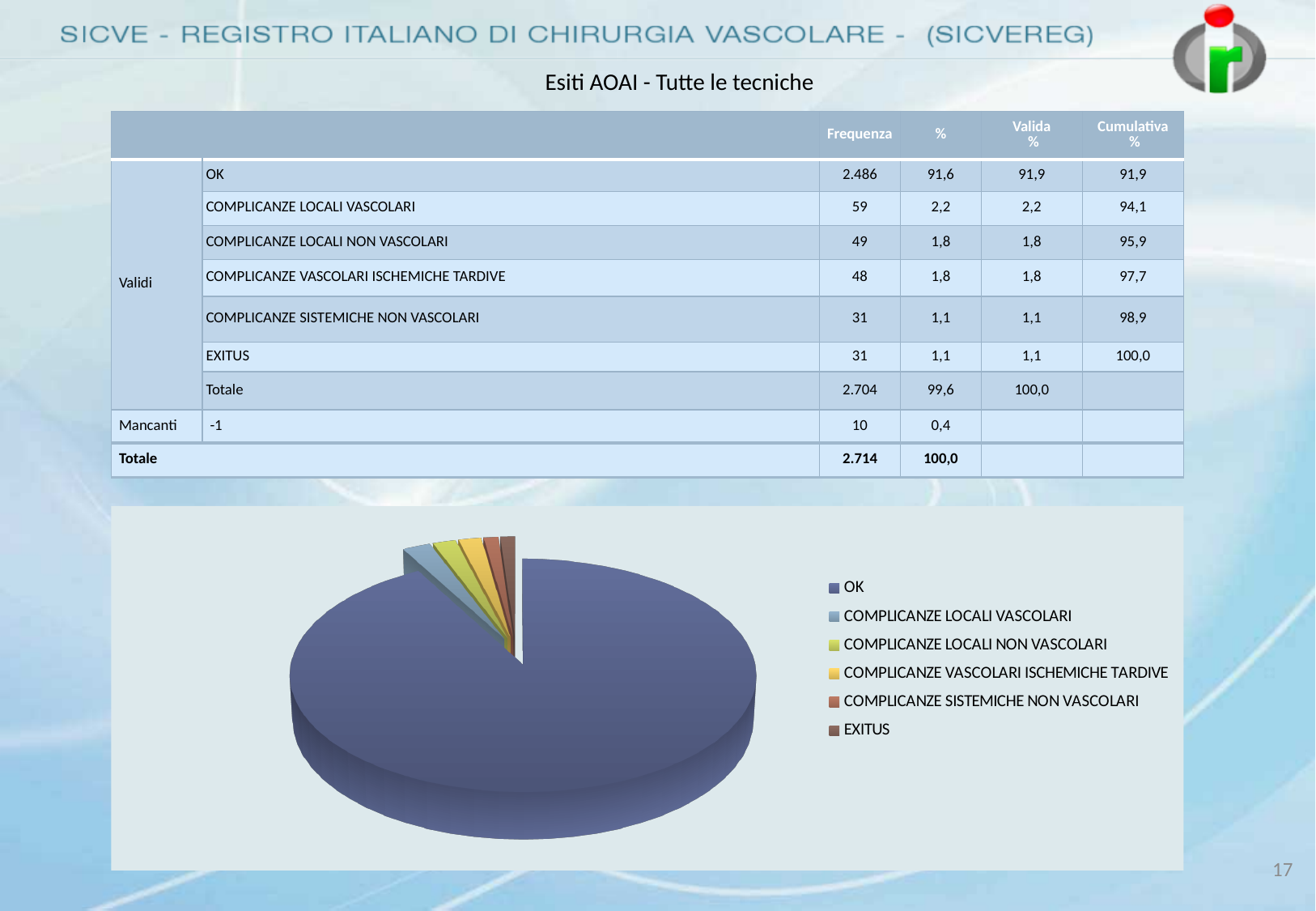
What is the Cumulativa % for COMPLICANZE VASCOLARI ISCHEMICHE TARDIVE? 97,7 What is the difference in frequency between COMPLICANZE LOCALI VASCOLARI and COMPLICANZE LOCALI NON VASCOLARI? 10 Which category has the largest slice in the pie chart? OK What is the frequency (Frequenza) for COMPLICANZE LOCALI VASCOLARI? 59 How many entries does the pie chart's legend list? 6 How many slices does the pie chart have? 6 What kind of chart is shown on the slide? pie chart What is the frequency (Frequenza) for the OK category shown in the table? 2.486 What is the Valida % for EXITUS? 1,1 Which is larger in the pie chart, the slice for OK or the slice for EXITUS? OK What is the title of the slide above the table and chart? Esiti AOAI - Tutte le tecniche What share of the valid cases (Valida %) does the OK slice represent? 91,9